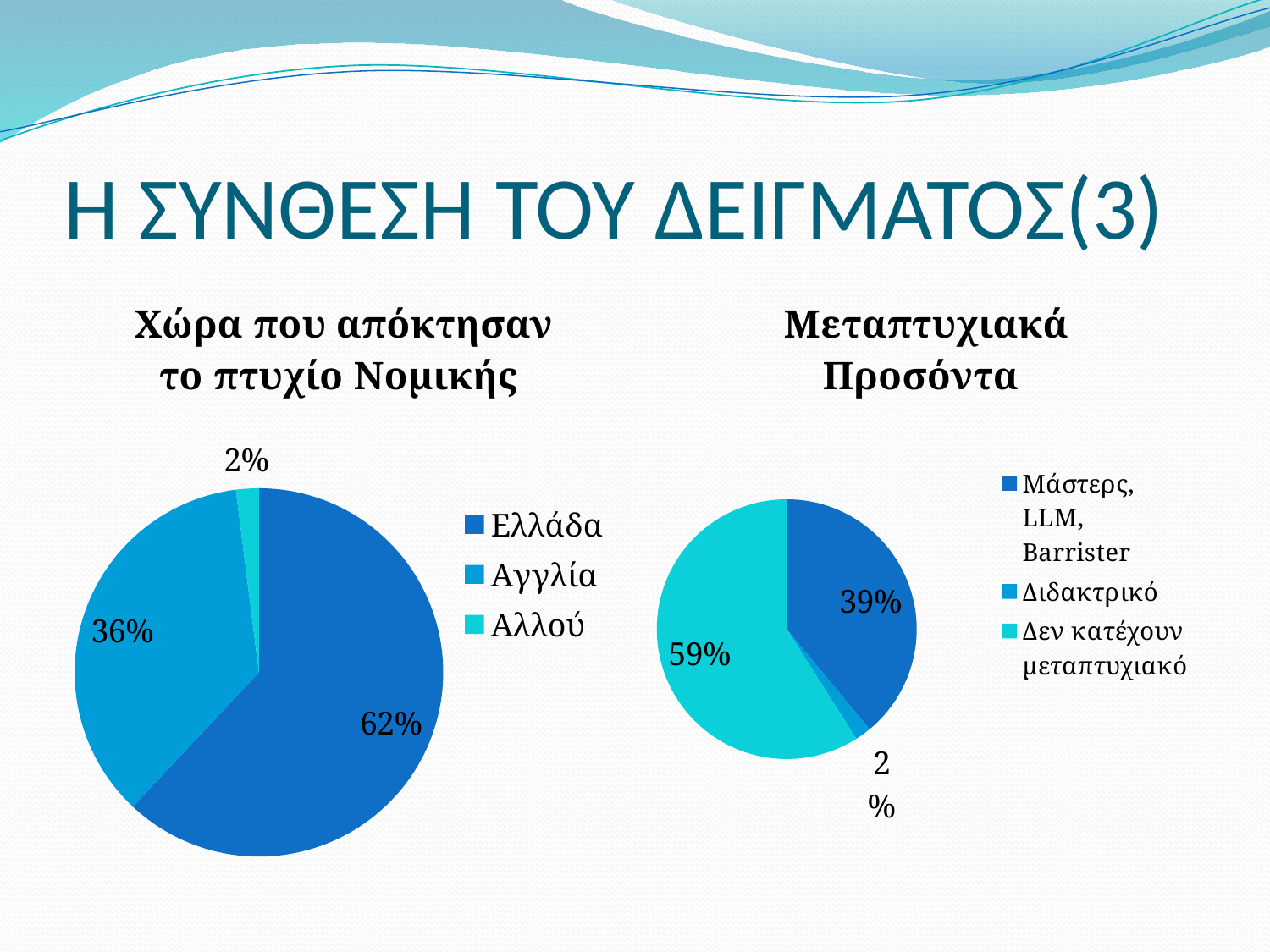
In the chart titled 'Μεταπτυχιακά Προσόντα', what is the value for Δεν κατέχουν μεταπτυχιακό? 59% In the chart titled 'Χώρα που απόκτησαν το πτυχίο Νομικής', what is the value for Αλλού? 2% In the chart titled 'Μεταπτυχιακά Προσόντα', what is the value for Διδακτρικό? 2% What kind of chart is the chart titled 'Χώρα που απόκτησαν το πτυχίο Νομικής'? Pie chart In the chart titled 'Χώρα που απόκτησαν το πτυχίο Νομικής', which category has the smallest slice? Αλλού How many categories does the legend of the chart titled 'Μεταπτυχιακά Προσόντα' list? 3 In the chart titled 'Χώρα που απόκτησαν το πτυχίο Νομικής', which category has the largest slice? Ελλάδα In the chart titled 'Χώρα που απόκτησαν το πτυχίο Νομικής', what is the difference between the Ελλάδα and Αγγλία shares? 26% In the chart titled 'Μεταπτυχιακά Προσόντα', which is larger: Μάστερς, LLM, Barrister or Δεν κατέχουν μεταπτυχιακό? Δεν κατέχουν μεταπτυχιακό In the chart titled 'Μεταπτυχιακά Προσόντα', what share of the pie is Μάστερς, LLM, Barrister? 39% In the chart titled 'Χώρα που απόκτησαν το πτυχίο Νομικής', what share of the pie is Ελλάδα? 62% In the chart titled 'Χώρα που απόκτησαν το πτυχίο Νομικής', what is the value for Αγγλία? 36%